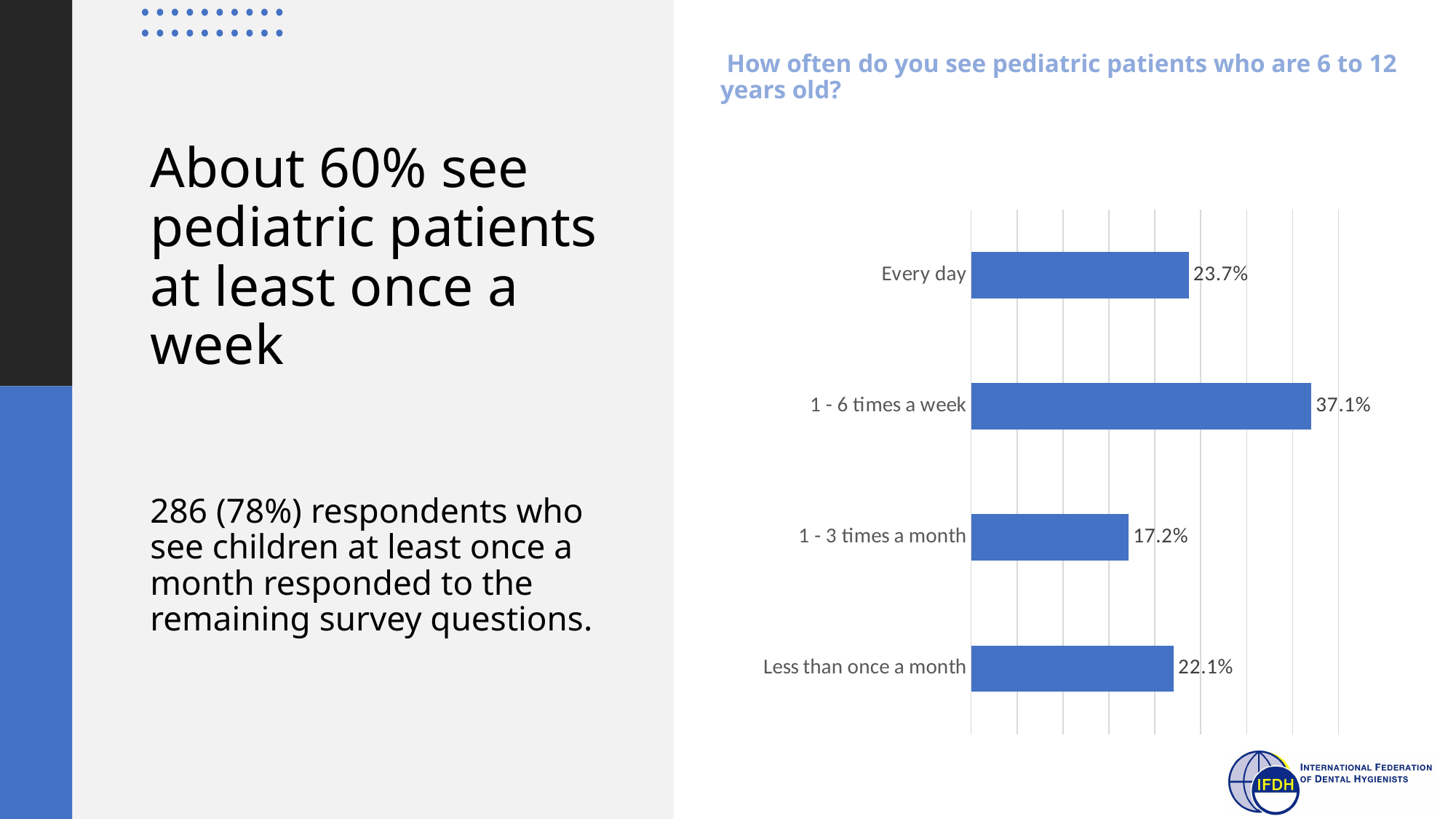
Which category has the highest value? 1 - 6 times a week What is the title of the chart? How often do you see pediatric patients who are 6 to 12 years old? What kind of chart is shown on the slide? Bar chart What colour are the bars in the chart? Blue How many categories are shown in the chart? 4 What is the difference between the values for '1 - 6 times a week' and 'Every day'? 13.4% What percentage of respondents see pediatric patients aged 6 to 12 every day? 23.7% Which category has the lowest value? 1 - 3 times a month What is the value for 'Less than once a month'? 22.1% What is the value for '1 - 3 times a month'? 17.2% What is the value for '1 - 6 times a week'? 37.1% Which is larger, the value for 'Every day' or the value for 'Less than once a month'? Every day